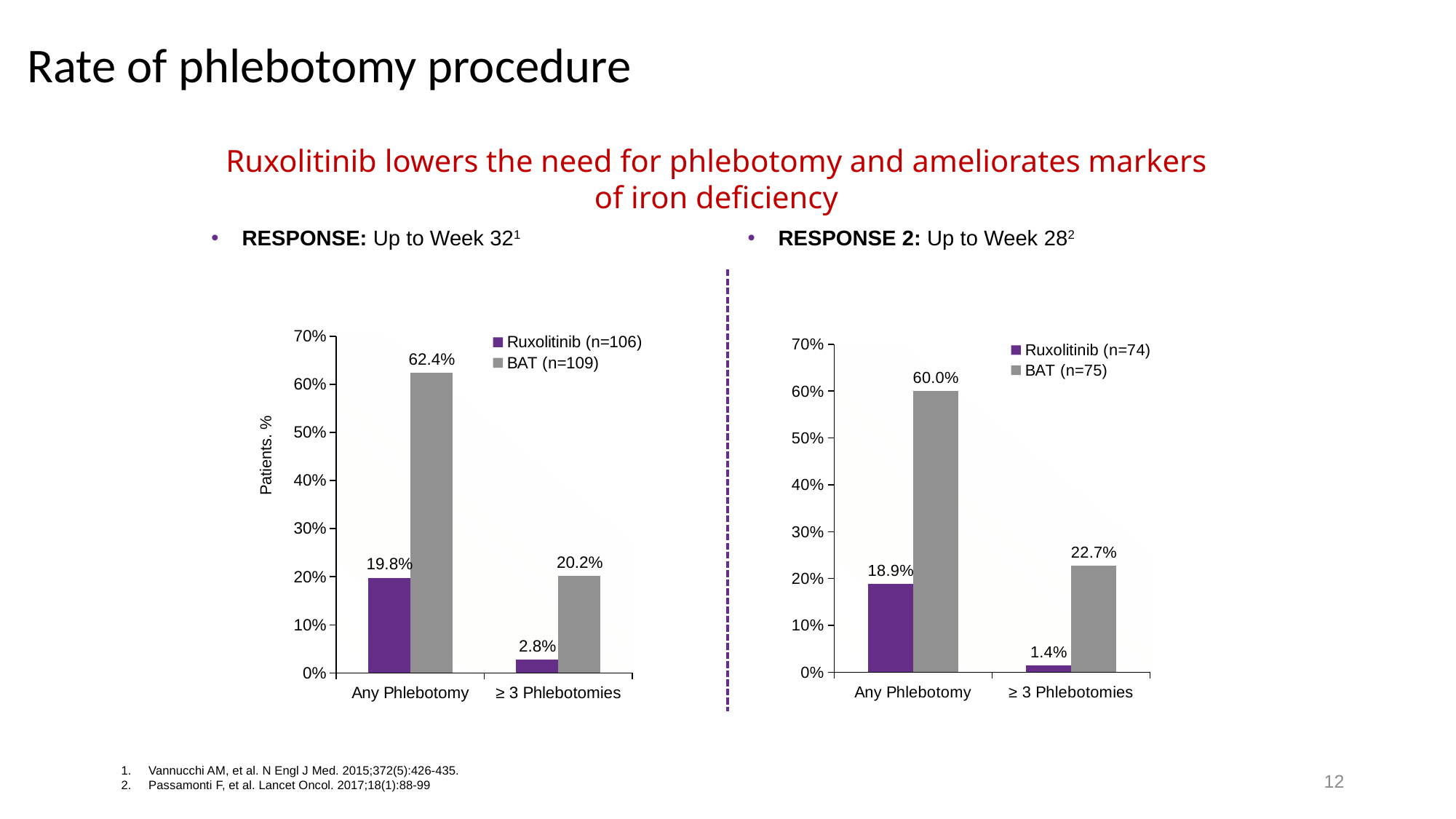
In the left chart (RESPONSE: Up to Week 32), what is the difference between the BAT and Ruxolitinib values for Any Phlebotomy? 42.6% In the left chart (RESPONSE: Up to Week 32), what is the value for BAT (n=109) for Any Phlebotomy? 62.4% In the right chart (RESPONSE 2: Up to Week 28), what is the value for BAT (n=75) for ≥ 3 Phlebotomies? 22.7% In the right chart (RESPONSE 2: Up to Week 28), what is the difference between the BAT and Ruxolitinib values for ≥ 3 Phlebotomies? 21.3% How many series does the legend of the right chart (RESPONSE 2: Up to Week 28) list? 2 In the left chart (RESPONSE: Up to Week 32), which is larger for ≥ 3 Phlebotomies: Ruxolitinib or BAT? BAT In the left chart (RESPONSE: Up to Week 32), which bar is the highest? BAT (n=109), Any Phlebotomy In the right chart (RESPONSE 2: Up to Week 28), what is the value for Ruxolitinib (n=74) for Any Phlebotomy? 18.9% What is the y-axis label of the left chart (RESPONSE: Up to Week 32)? Patients. % What kind of chart is the left chart (RESPONSE: Up to Week 32)? Bar chart In the left chart (RESPONSE: Up to Week 32), what is the value for Ruxolitinib (n=106) for ≥ 3 Phlebotomies? 2.8% In the right chart (RESPONSE 2: Up to Week 28), which bar is the lowest? Ruxolitinib (n=74), ≥ 3 Phlebotomies